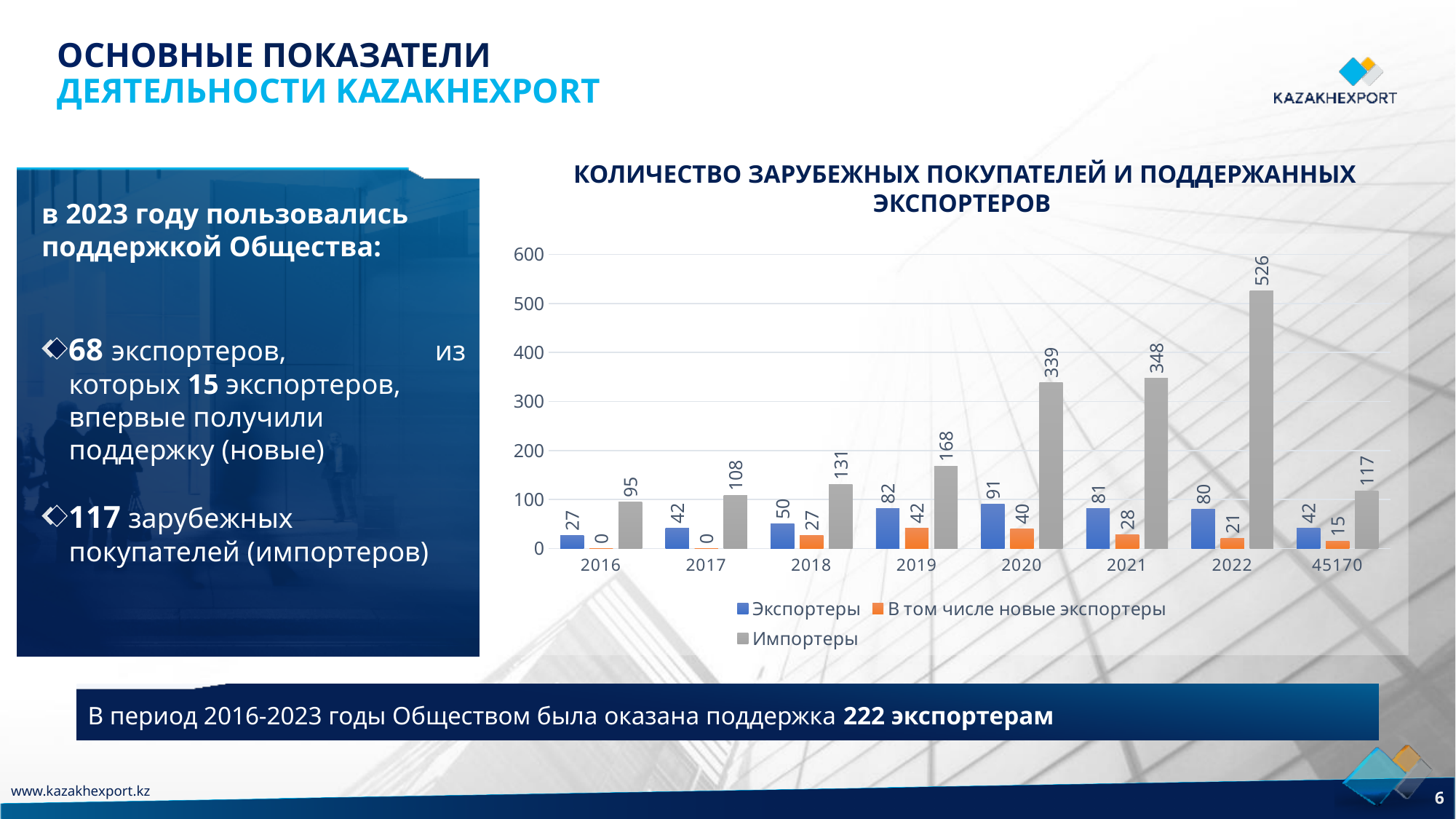
How many series does the chart legend list? 3 In which year is the value for Экспортеры the lowest? 2016 What is the value for Экспортеры in 2020? 91 In which year is the value for Импортеры the highest? 2022 What is the value for Импортеры in 2022? 526 What is the title of the chart? КОЛИЧЕСТВО ЗАРУБЕЖНЫХ ПОКУПАТЕЛЕЙ И ПОДДЕРЖАННЫХ ЭКСПОРТЕРОВ Which is larger: the Экспортеры value for 2019 or for 2021? 2019 What is the difference between the Импортеры values for 2022 and 2021? 178 Do the Импортеры values rise or fall from 2016 to 2022? rise What type of chart is shown on the slide? bar chart How many categories are shown on the x axis of the chart? 8 What is the value for В том числе новые экспортеры in 2019? 42